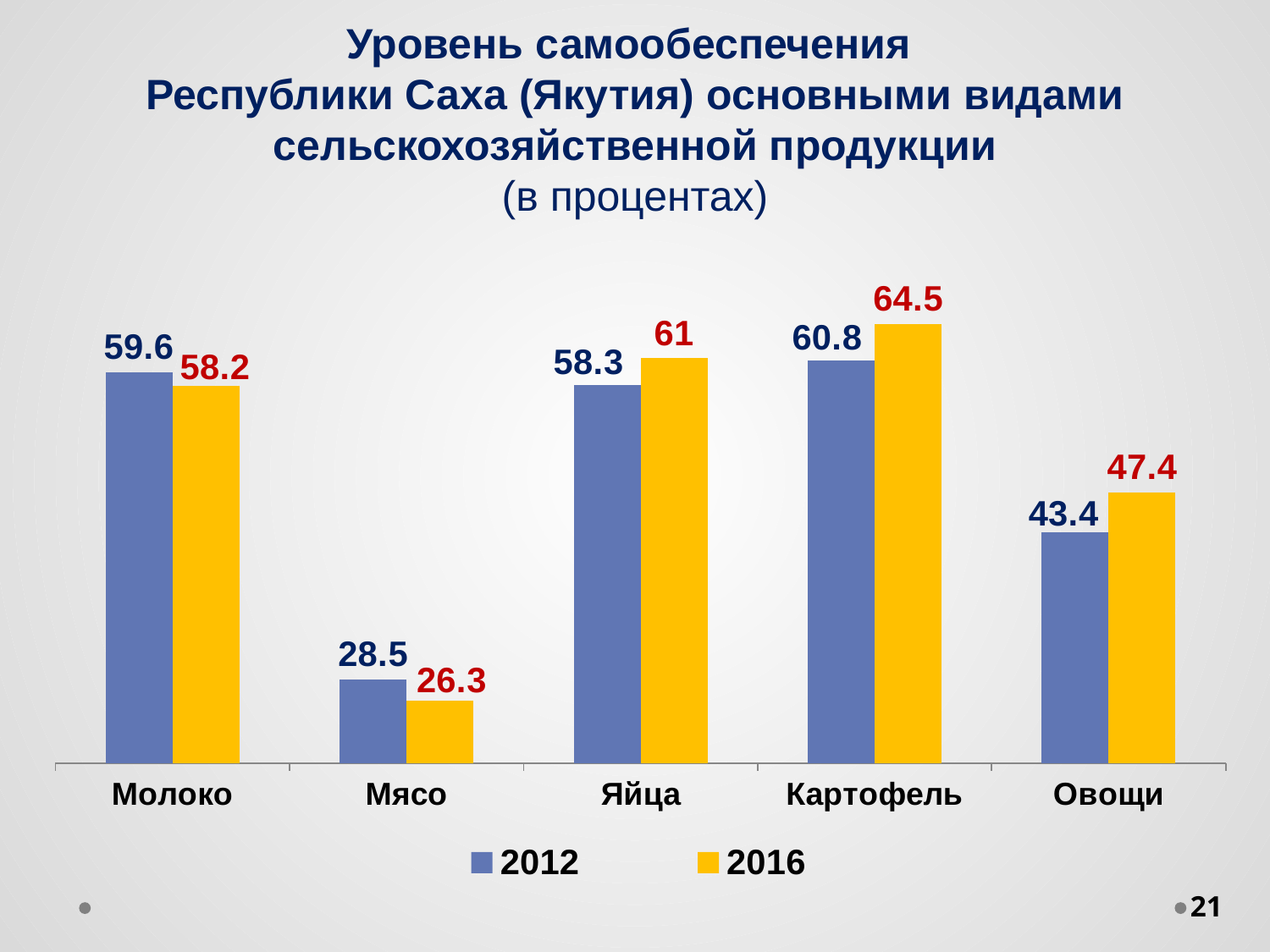
What is the difference between the 2016 and 2012 values for Картофель? 3.7 How many categories are shown on the x axis? 5 Which category has the highest value in 2016? Картофель Which is larger for Молоко: the 2012 value or the 2016 value? 2012 What is the difference between the 2012 and 2016 values for Мясо? 2.2 Which category has the lowest value in 2012? Мясо What is the value for Мясо in 2016? 26.3 What is the value for Овощи in 2016? 47.4 Which is larger for Яйца: the 2012 value or the 2016 value? 2016 How many series does the legend list? 2 What is the value for Молоко in 2012? 59.6 What kind of chart is shown on the slide? Bar chart